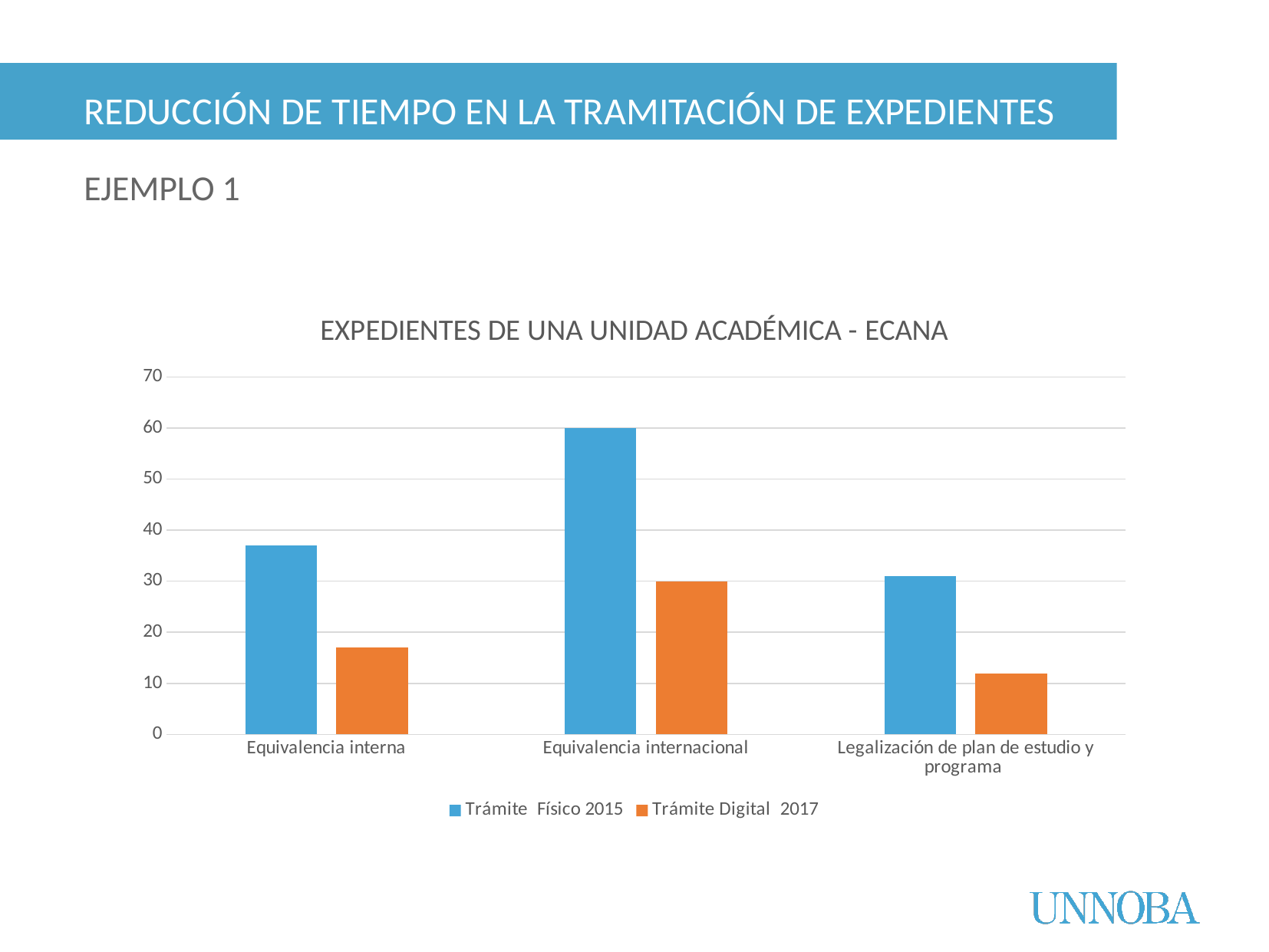
Is the value of Trámite Digital 2017 for Equivalencia interna greater or less than 20? less For Equivalencia interna, which series has the larger value, Trámite Físico 2015 or Trámite Digital 2017? Trámite Físico 2015 Which category has the highest value for Trámite Físico 2015? Equivalencia internacional What is the title of the chart? EXPEDIENTES DE UNA UNIDAD ACADÉMICA - ECANA What is the value of Trámite Físico 2015 for Equivalencia internacional? 60 How many series does the legend list? 2 How many categories are shown on the x axis? 3 What is the value of Trámite Digital 2017 for Equivalencia internacional? 30 Is the value of Trámite Físico 2015 for Equivalencia interna greater or less than 30? greater Which category has the lowest value for Trámite Digital 2017? Legalización de plan de estudio y programa What kind of chart is shown on the slide? bar chart Is the value of Trámite Digital 2017 for Legalización de plan de estudio y programa greater or less than 20? less